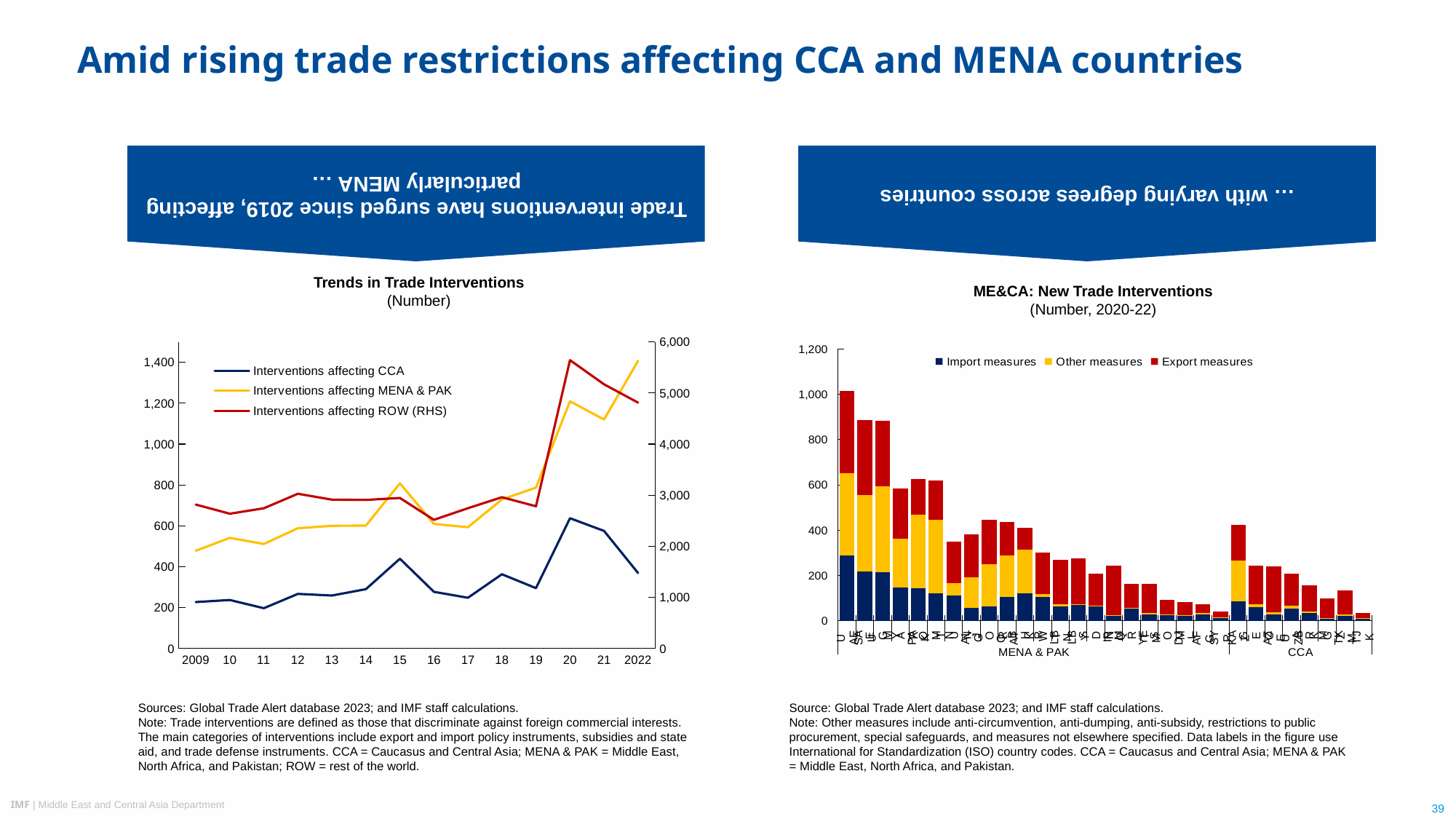
In the 'Trends in Trade Interventions' chart, is the value for 'Interventions affecting ROW (RHS)' in 2020 greater or less than 5,000? greater What kind of chart is the 'ME&CA: New Trade Interventions' chart on the right? bar chart In the 'Trends in Trade Interventions' chart, in which year does the 'Interventions affecting MENA & PAK' line reach its highest value? 2022 In the 'Trends in Trade Interventions' chart, which series is plotted on the right-hand axis? Interventions affecting ROW (RHS) In the 'ME&CA: New Trade Interventions' chart, which colour represents 'Export measures'? red How many series does the legend of the 'Trends in Trade Interventions' chart list? 3 How many series does the legend of the 'ME&CA: New Trade Interventions' chart list? 3 In the 'Trends in Trade Interventions' chart, is the value for 'Interventions affecting CCA' in 2020 greater or less than 400? greater In the 'Trends in Trade Interventions' chart, in which year does the 'Interventions affecting CCA' line reach its highest value? 2020 In the 'Trends in Trade Interventions' chart, does the 'Interventions affecting CCA' line rise or fall from 2020 to 2022? fall What kind of chart is the 'Trends in Trade Interventions' chart on the left? line chart In the 'Trends in Trade Interventions' chart, is the value for 'Interventions affecting MENA & PAK' in 2022 greater or less than 1,200? greater